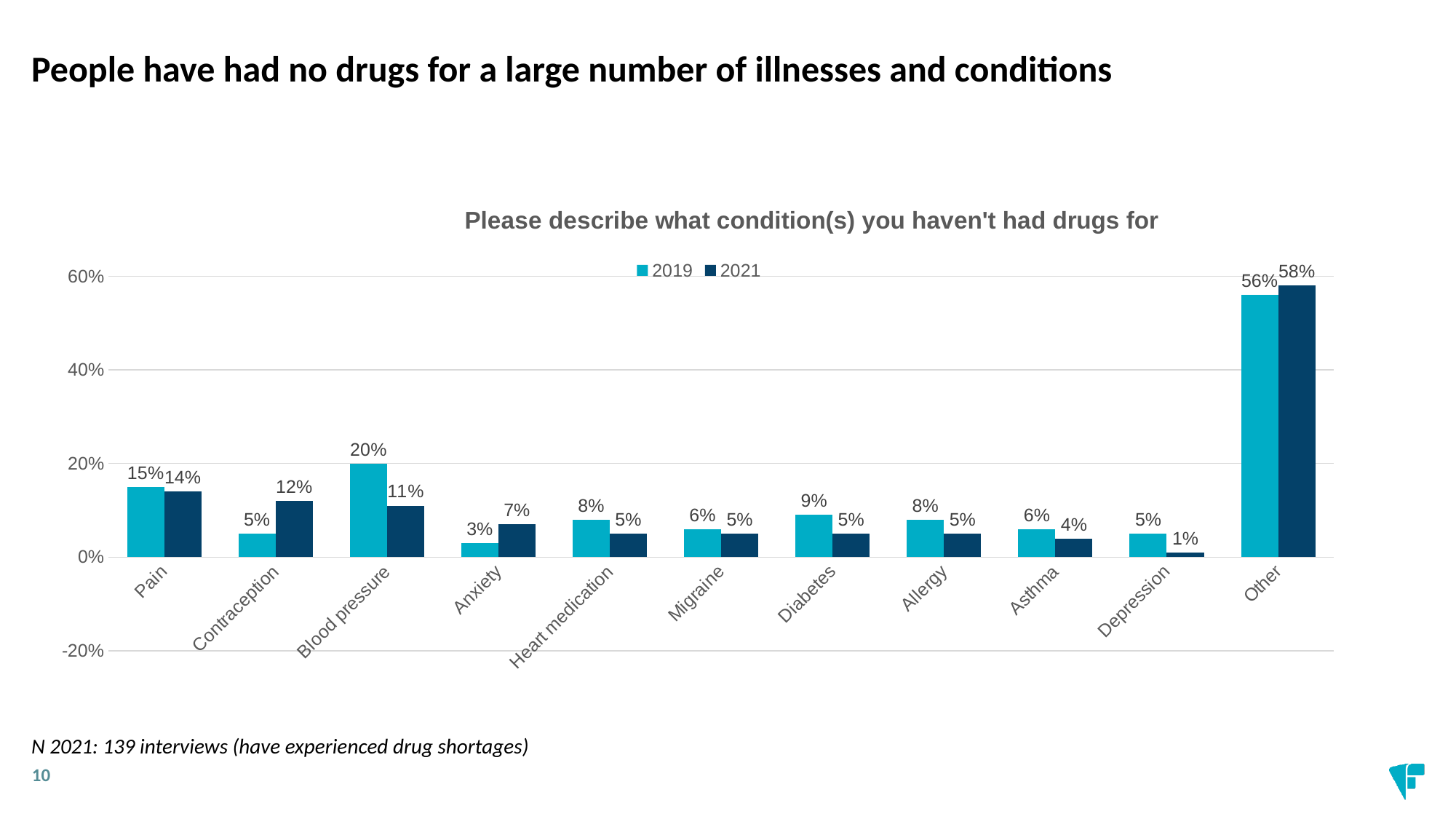
What is the 2021 value for Depression? 1% How many categories are shown on the x axis? 11 What is the difference between the 2019 and 2021 values for Blood pressure? 9% Which category has the lowest 2019 value? Anxiety How many series does the legend list? 2 What is the title of the chart? Please describe what condition(s) you haven't had drugs for Which is larger for Anxiety, the 2019 value or the 2021 value? 2021 What kind of chart is shown on the slide? Bar chart What is the 2019 value for Diabetes? 9% What is the 2019 value for Blood pressure? 20% Which category has the highest 2021 value? Other What is the 2021 value for Contraception? 12%